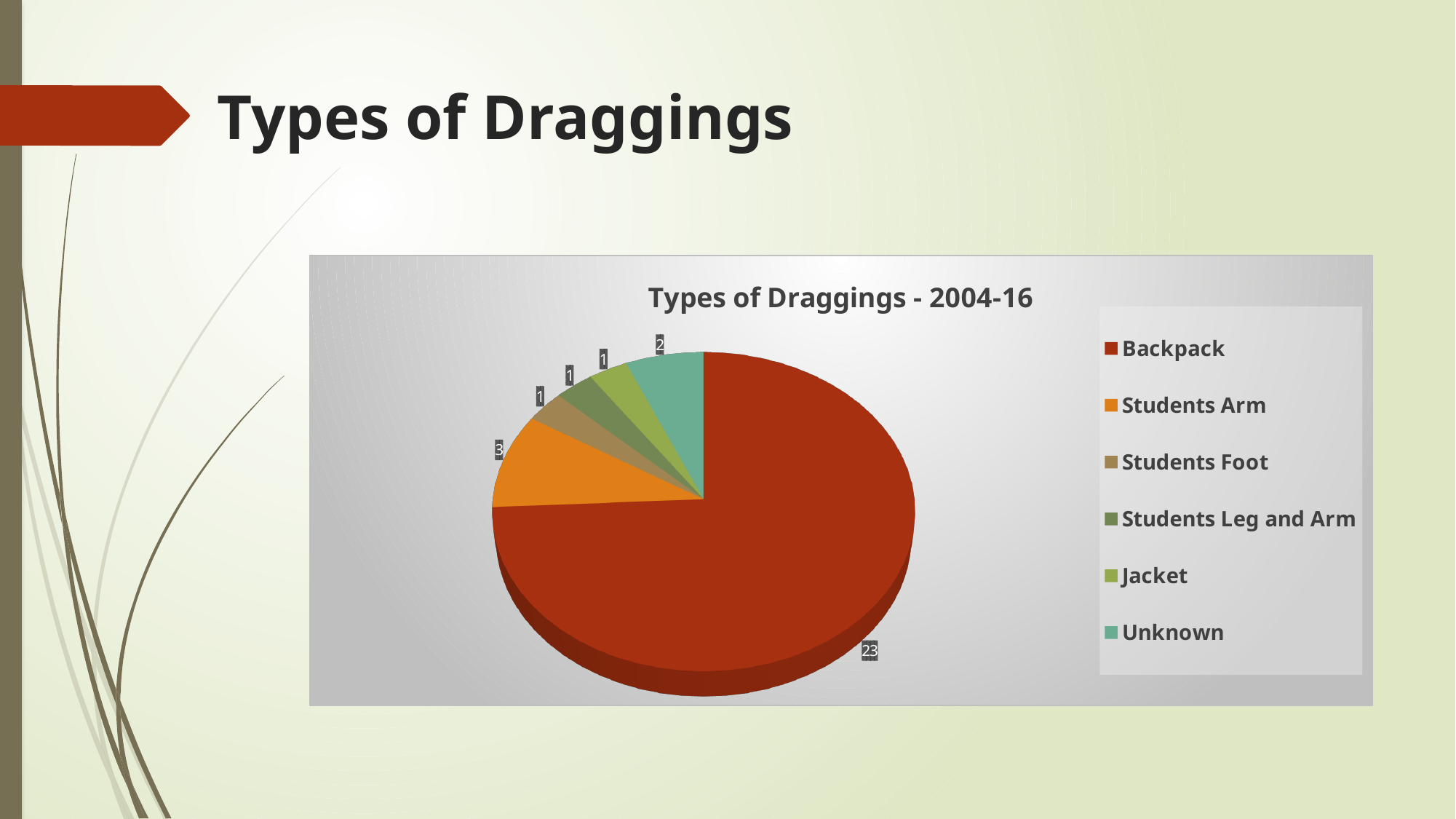
What is the total of all the slices in the pie? 31 What is the value for Backpack? 23 Which category has the largest slice of the pie? Backpack Which is larger, the value for Unknown or the value for Students Foot? Unknown How many categories does the legend list? 6 What is the value for Unknown? 2 What is the value for Students Arm? 3 Which colour represents Students Arm in the legend? orange What is the title of the chart? Types of Draggings - 2004-16 What is the difference between the values for Backpack and Students Arm? 20 What is the value for Jacket? 1 What type of chart is shown on the slide? pie chart